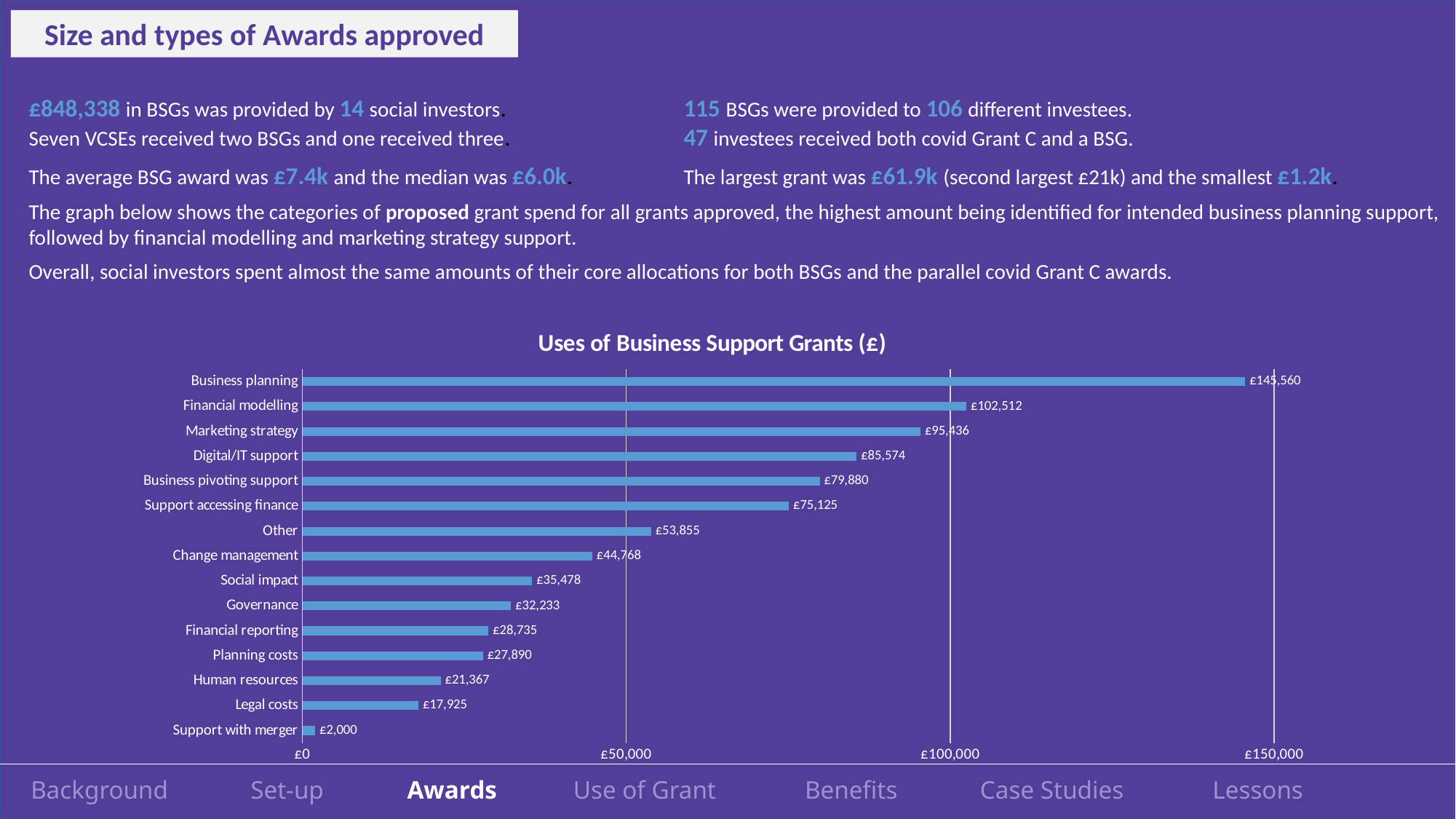
Is the value for Business planning greater or less than £100,000? greater What is the difference between Human resources and Legal costs? £3,442 Which category has the lowest value? Support with merger What is the difference between Financial modelling and Marketing strategy? £7,076 Which category has the highest value? Business planning Which is larger, Other or Change management? Other How many categories are shown in the chart? 15 What is the value for Legal costs? £17,925 What is the title of the chart? Uses of Business Support Grants (£) What is the value for Financial modelling? £102,512 What type of chart is shown on the slide? bar chart What is the value for Digital/IT support? £85,574